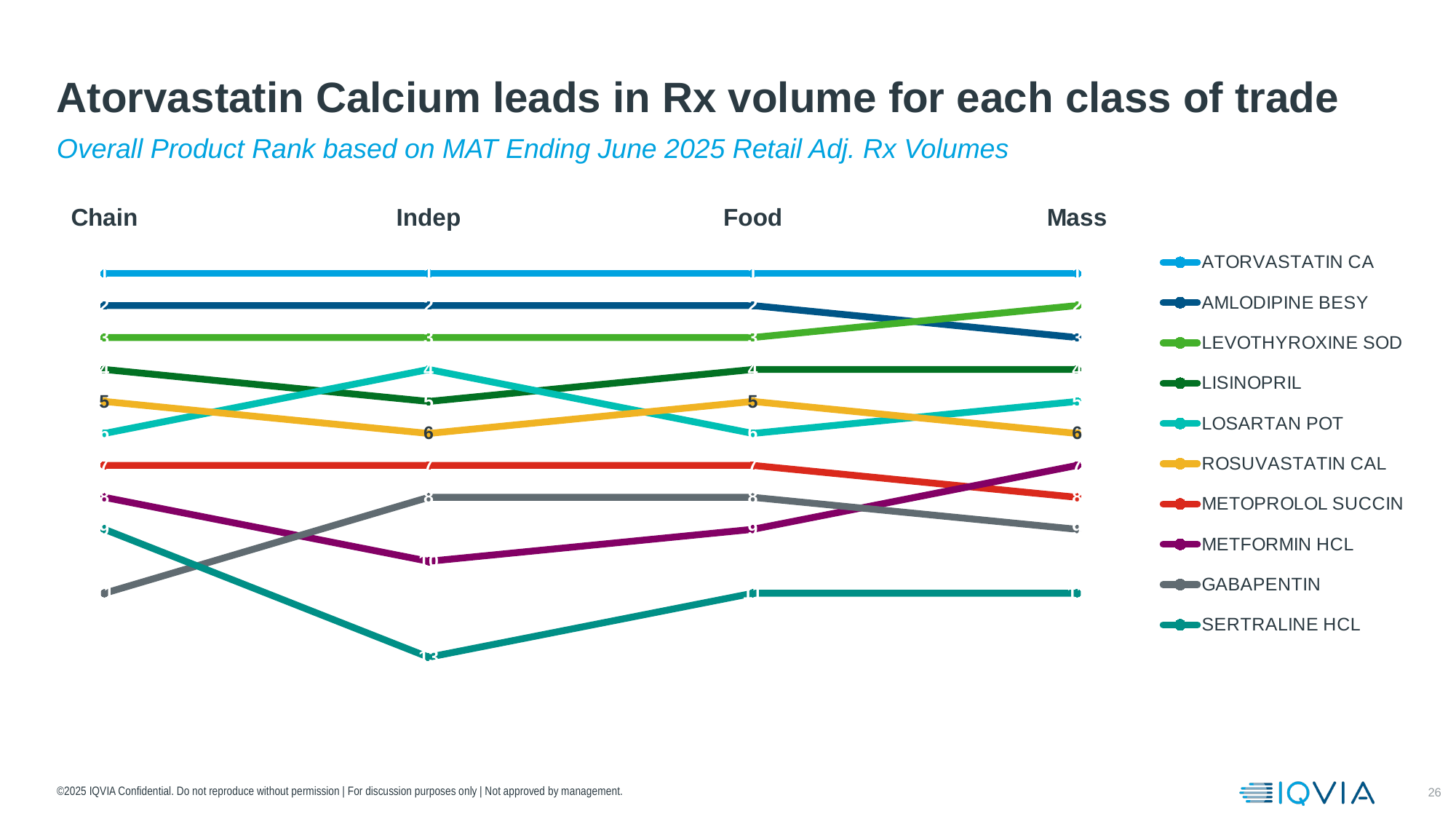
How many series does the legend list? 10 By how many rank positions does ROSUVASTATIN CAL differ between Chain and Indep? 1 What is the subtitle of the chart? Overall Product Rank based on MAT Ending June 2025 Retail Adj. Rx Volumes Does the line for SERTRALINE HCL move up or down from Chain to Indep? Down Which product is plotted at the top position in every class of trade? ATORVASTATIN CA What is the rank of ROSUVASTATIN CAL in the Mass class of trade? 6 Which product is listed last in the legend? SERTRALINE HCL How many classes of trade are plotted along the x axis? 4 Which product is plotted at the lowest position in the Indep class of trade? SERTRALINE HCL What kind of chart is shown on the slide? Line chart What is the rank of ROSUVASTATIN CAL in the Indep class of trade? 6 What is the rank of ROSUVASTATIN CAL in the Chain class of trade? 5